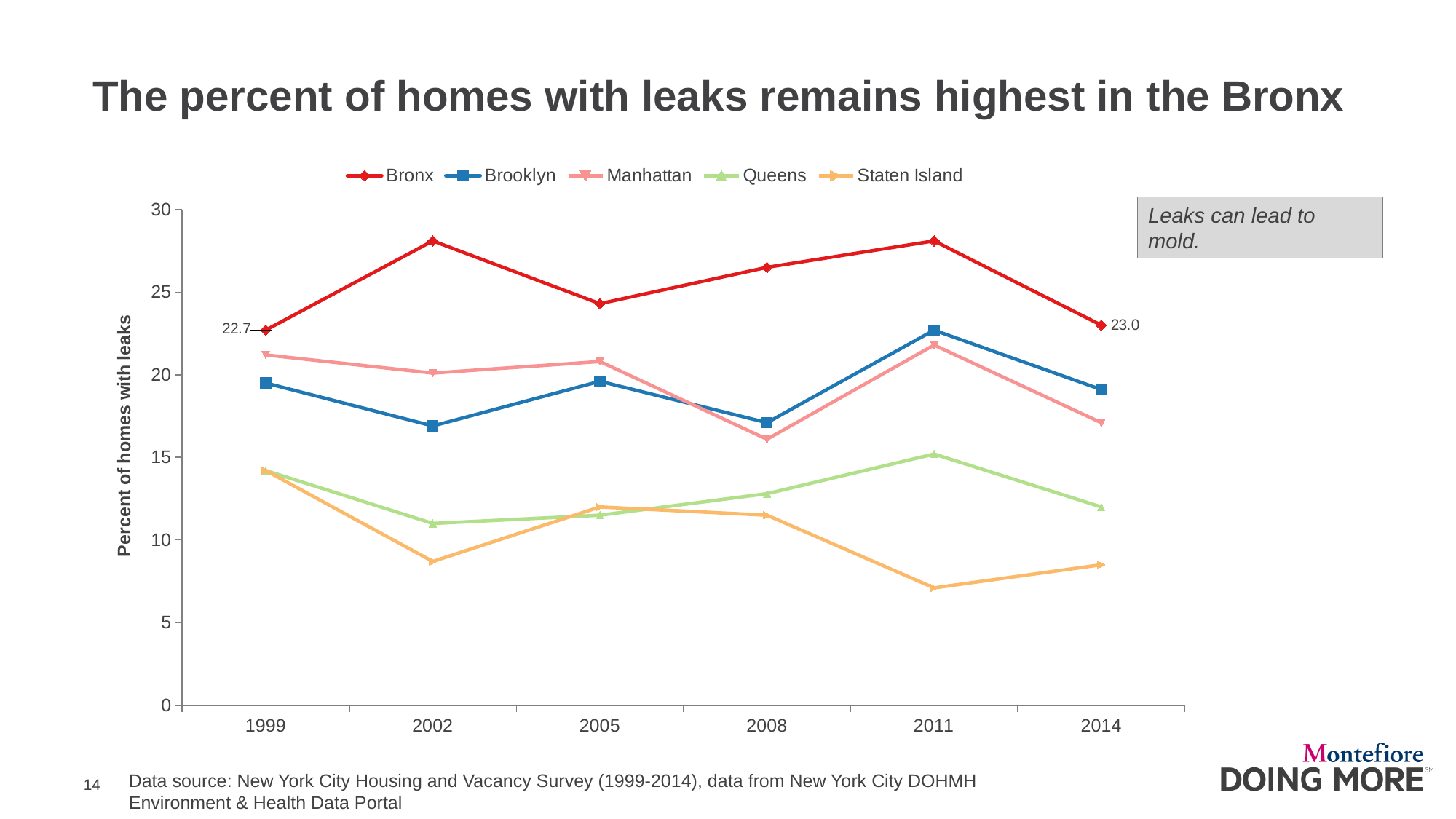
How many series does the legend list? 5 Is the value for the Bronx in 2002 greater or less than 25? greater What kind of chart is shown on the slide? Line chart By how much does the Bronx value in 2014 differ from its value in 1999? 0.3 What is the value for the Bronx in 1999? 22.7 Which borough has the lowest percent of homes with leaks in 2011? Staten Island How many years are shown on the x axis? 6 Is the value for Staten Island in 2011 greater or less than 10? less Does the Bronx value rise or fall from 2011 to 2014? fall What is the value for the Bronx in 2014? 23.0 In 2008, which is larger: the value for Brooklyn or the value for Manhattan? Brooklyn Which borough has the highest percent of homes with leaks in 2014? Bronx